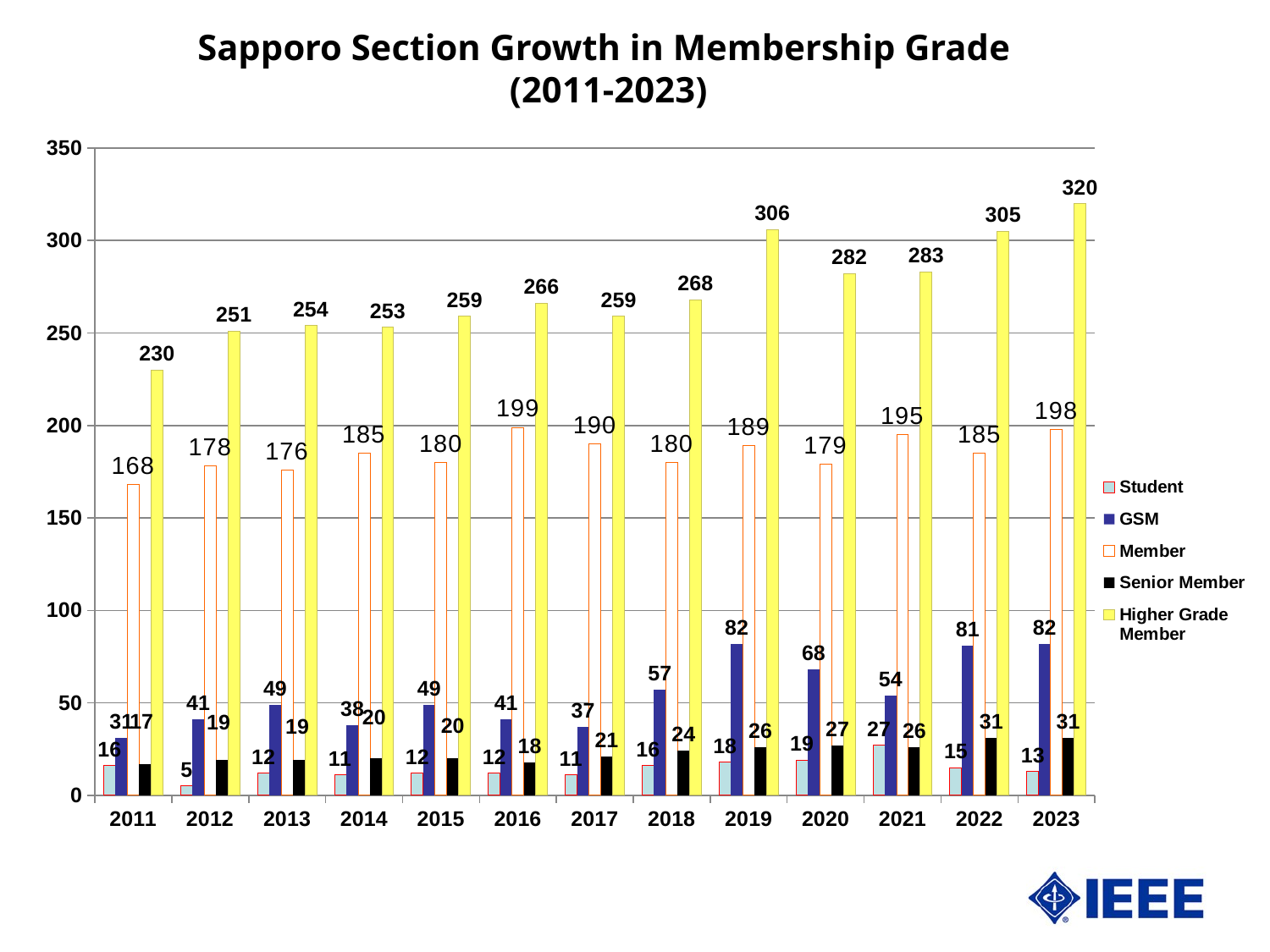
How many years are shown on the x axis? 13 What is the value for Higher Grade Member in 2023? 320 How many series does the legend list? 5 Which is larger, the Member value in 2021 or the Member value in 2022? 2021 What is the value for Member in 2016? 199 What is the value for GSM in 2019? 82 What is the title of the chart? Sapporo Section Growth in Membership Grade (2011-2023) What is the difference between the Higher Grade Member values in 2023 and 2011? 90 What is the value for Student in 2021? 27 What kind of chart is shown on the slide? Bar chart In which year is the Student value lowest? 2012 In which year is the Higher Grade Member value highest? 2023